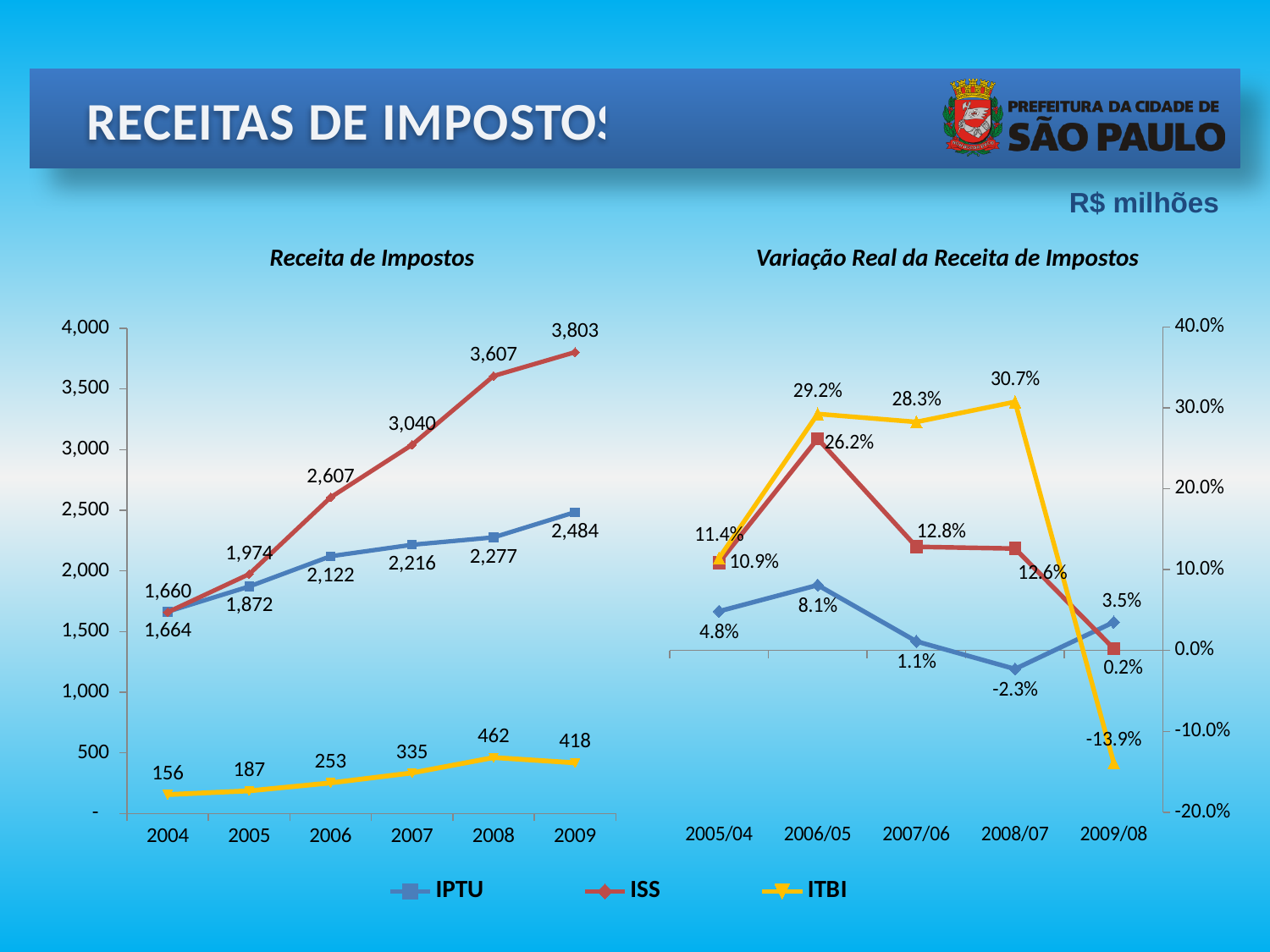
In the 'Receita de Impostos' chart, in which year is the ITBI value highest? 2008 In the 'Variação Real da Receita de Impostos' chart, which is larger in 2006/05, ISS or IPTU? ISS In the 'Receita de Impostos' chart, does the IPTU value rise or fall from 2004 to 2009? Rise In the 'Receita de Impostos' chart, what is the ITBI value for 2008? 462 How many years are shown on the x axis of the 'Receita de Impostos' chart? 6 In the 'Variação Real da Receita de Impostos' chart, what is the ITBI value for 2009/08? -13.9% What kind of chart is the 'Receita de Impostos' chart? Line chart In the 'Variação Real da Receita de Impostos' chart, does the ISS value rise or fall from 2006/05 to 2009/08? Fall In the 'Variação Real da Receita de Impostos' chart, in which period is the IPTU value lowest? 2008/07 In the 'Receita de Impostos' chart, what is the difference between the ISS and IPTU values in 2009? 1,319 How many series does the legend list? 3 In the 'Receita de Impostos' chart, what is the ISS value for 2009? 3,803